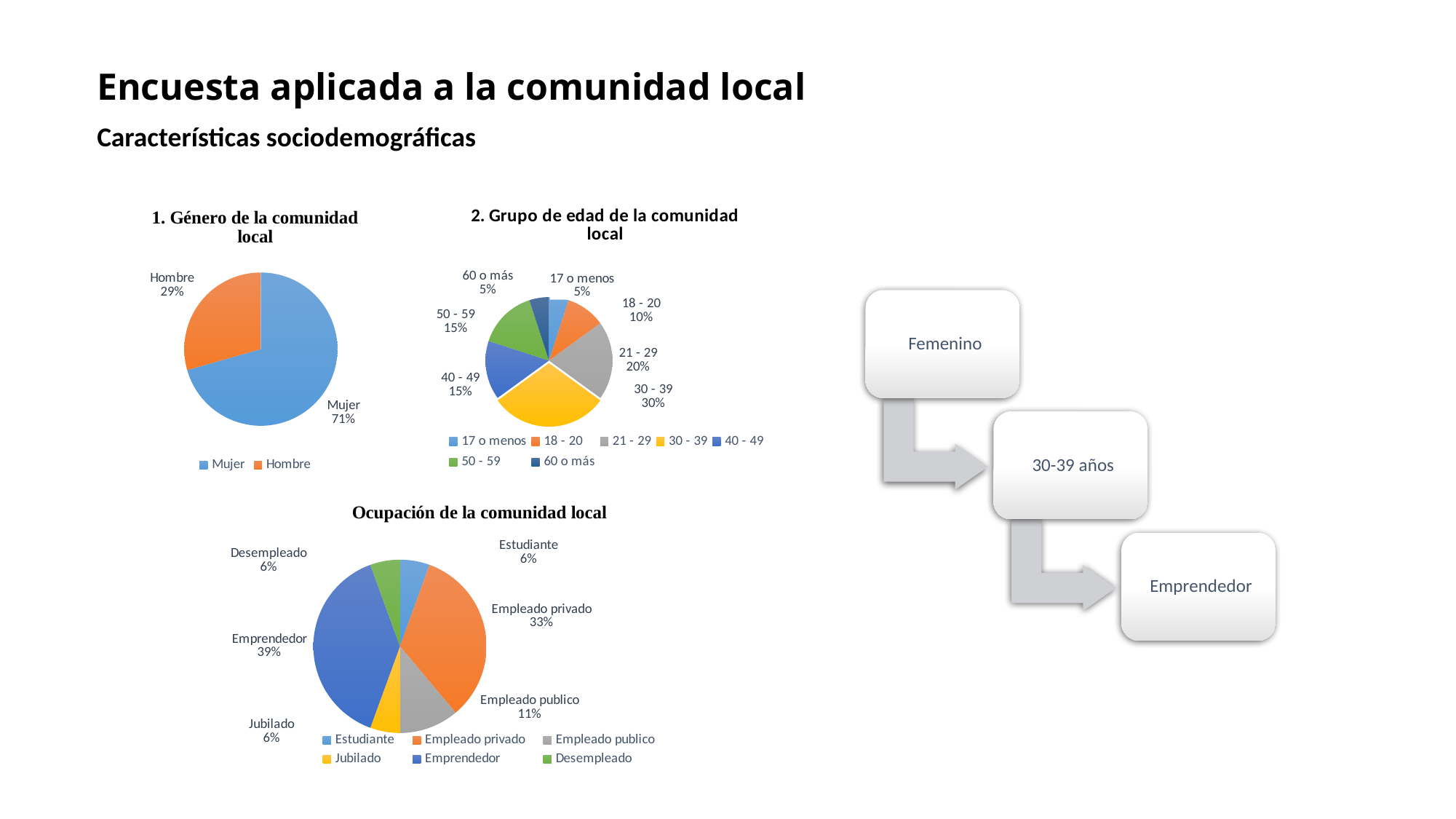
In the chart '2. Grupo de edad de la comunidad local', what is the value for 21 - 29? 20% In the chart '1. Género de la comunidad local', what is the value for Hombre? 29% In the chart 'Ocupación de la comunidad local', what is the value for Empleado publico? 11% How many categories does the legend of 'Ocupación de la comunidad local' list? 6 In the chart '2. Grupo de edad de la comunidad local', which age group has the largest share? 30 - 39 In the chart '1. Género de la comunidad local', what is the difference between Mujer and Hombre? 42% In the chart 'Ocupación de la comunidad local', what is the difference between Emprendedor and Empleado privado? 6% In the chart 'Ocupación de la comunidad local', which occupation has the largest share? Emprendedor What kind of chart is '2. Grupo de edad de la comunidad local'? pie chart In the chart '2. Grupo de edad de la comunidad local', which is larger, 18 - 20 or 40 - 49? 40 - 49 In the chart '1. Género de la comunidad local', what share of the pie is Mujer? 71% How many categories does the legend of '2. Grupo de edad de la comunidad local' list? 7